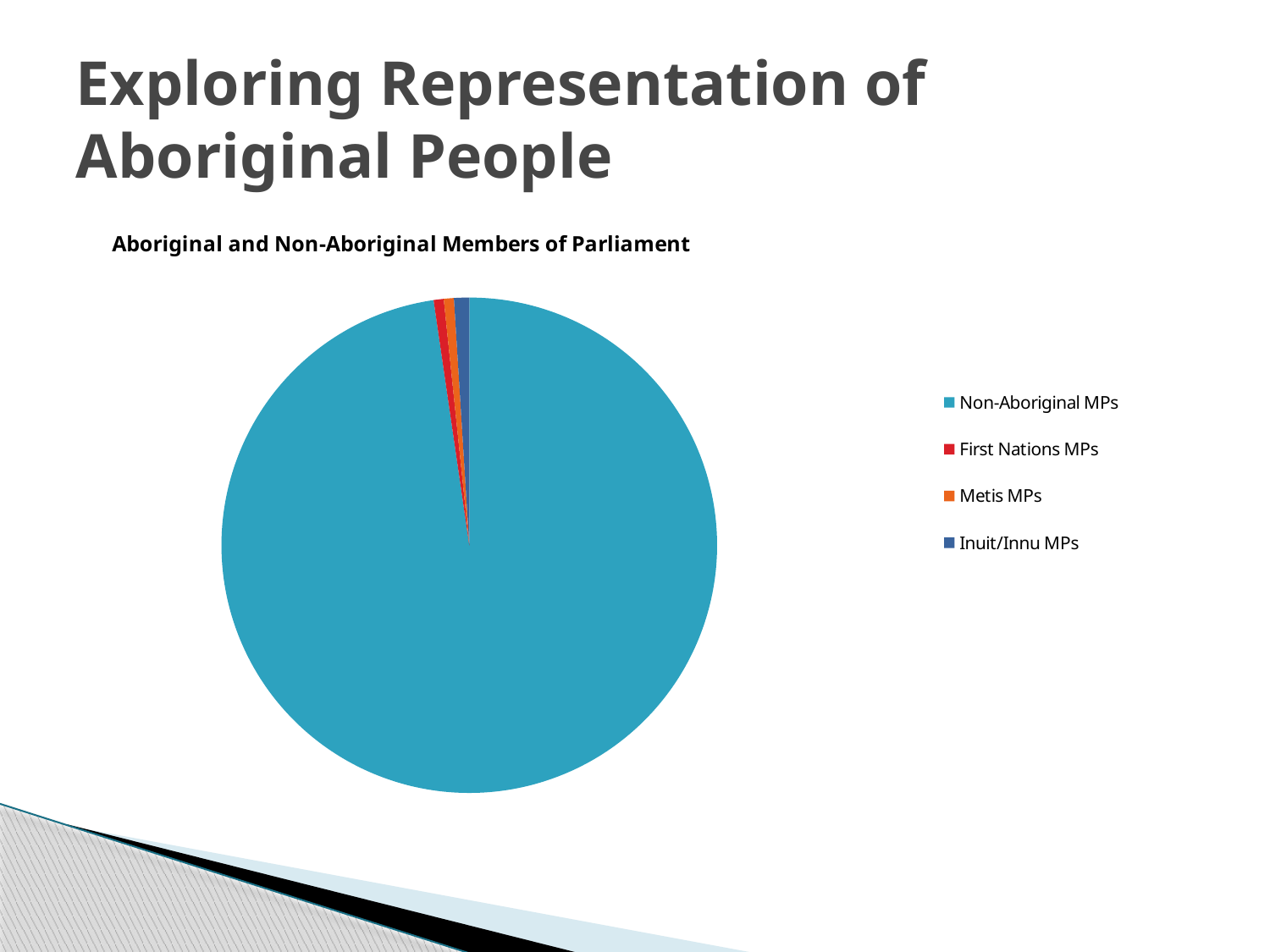
What kind of chart is shown on the slide? Pie chart Which is larger: the slice for Non-Aboriginal MPs or the slice for First Nations MPs? Non-Aboriginal MPs How many entries does the legend list? 4 Which is larger: the slice for Inuit/Innu MPs or the slice for Non-Aboriginal MPs? Non-Aboriginal MPs How many categories does the pie chart show? 4 Which category has the largest slice of the pie? Non-Aboriginal MPs What is the title of the chart? Aboriginal and Non-Aboriginal Members of Parliament What colour is the slice for Non-Aboriginal MPs? Blue (teal) Which is larger: the slice for Non-Aboriginal MPs or the slice for Metis MPs? Non-Aboriginal MPs